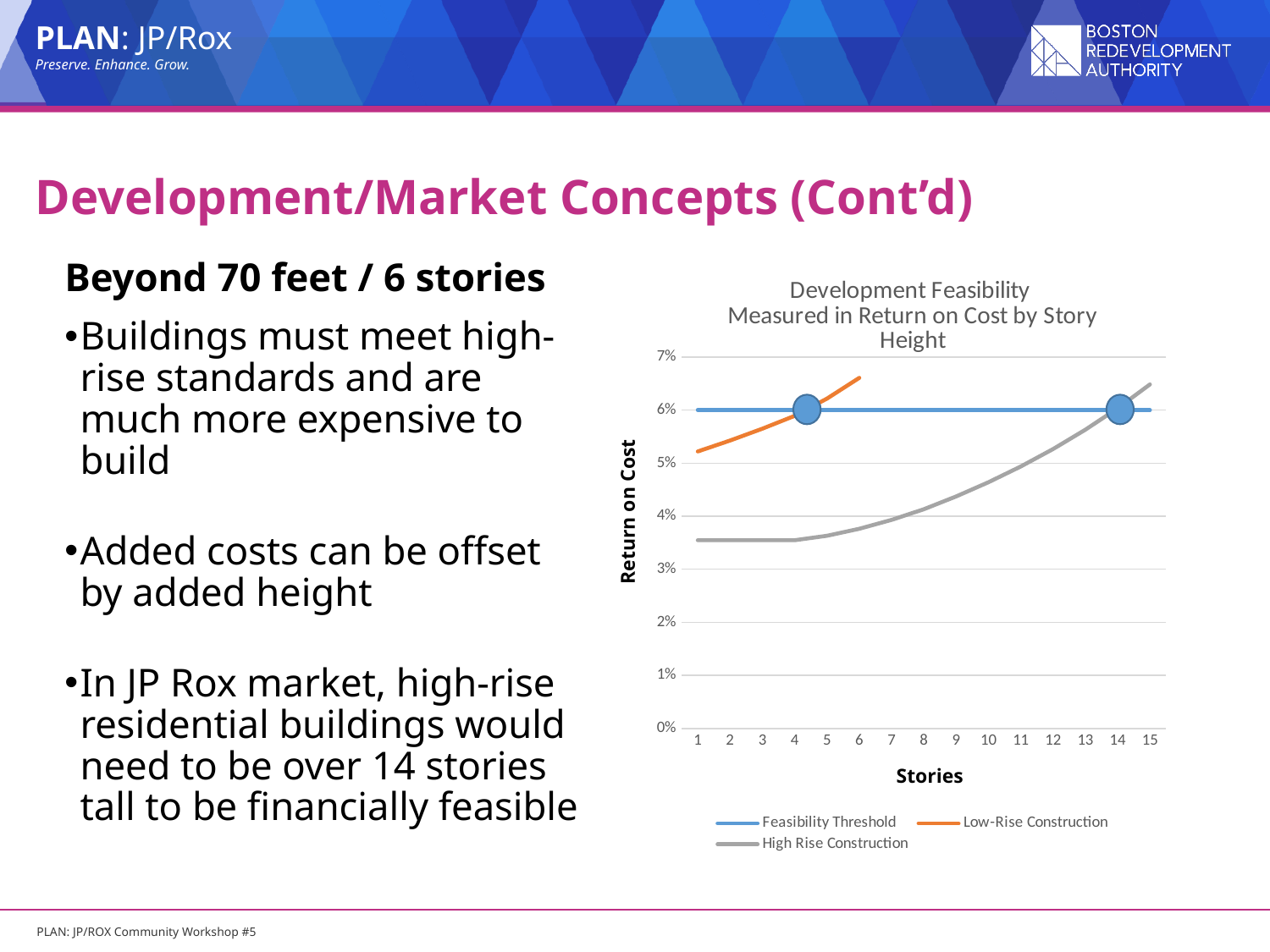
At 3 stories, which is higher: Low-Rise Construction or High Rise Construction? Low-Rise Construction How many series does the legend list? 3 How many story values are shown along the x axis? 15 Is the value for High Rise Construction at 1 story greater or less than 4%? less What is the label of the vertical axis? Return on Cost Is the value for High Rise Construction at 15 stories greater or less than 6%? greater Is the value for Low-Rise Construction at 6 stories greater or less than 6%? greater What return on cost does the Feasibility Threshold line sit at? 6% What kind of chart is shown on the slide? line chart Does the High Rise Construction line rise or fall as the number of stories increases? rise What is the title of the chart? Development Feasibility Measured in Return on Cost by Story Height